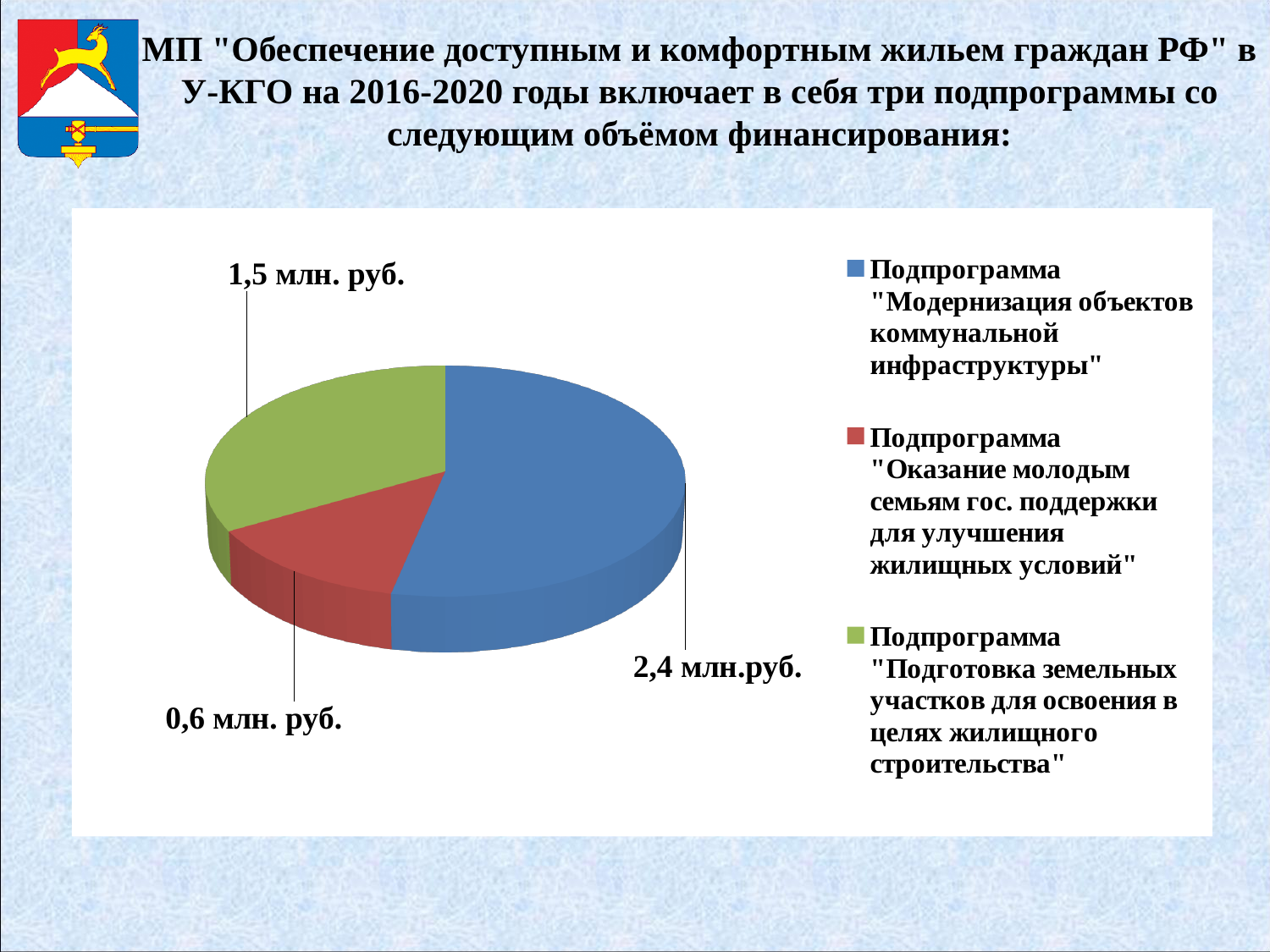
Which is larger: the funding for "Подготовка земельных участков" or for "Оказание молодым семьям гос. поддержки"? Подготовка земельных участков What is the funding amount for the subprogram "Модернизация объектов коммунальной инфраструктуры"? 2,4 млн.руб. What is the total funding across all three subprograms shown in the pie chart? 4,5 млн. руб. What is the funding amount for the subprogram "Подготовка земельных участков для освоения в целях жилищного строительства"? 1,5 млн. руб. How many slices does the pie chart have? 3 Which subprogram has the smallest funding amount in the pie chart? Подпрограмма "Оказание молодым семьям гос. поддержки для улучшения жилищных условий" What kind of chart is shown on the slide? Pie chart What colour is the slice for the subprogram "Оказание молодым семьям гос. поддержки для улучшения жилищных условий"? Red Which subprogram has the largest funding amount in the pie chart? Подпрограмма "Модернизация объектов коммунальной инфраструктуры" What is the difference between the funding for "Модернизация объектов коммунальной инфраструктуры" and "Подготовка земельных участков для освоения в целях жилищного строительства"? 0,9 млн. руб. What is the funding amount for the subprogram "Оказание молодым семьям гос. поддержки для улучшения жилищных условий"? 0,6 млн. руб. How many entries does the legend of the pie chart list? 3